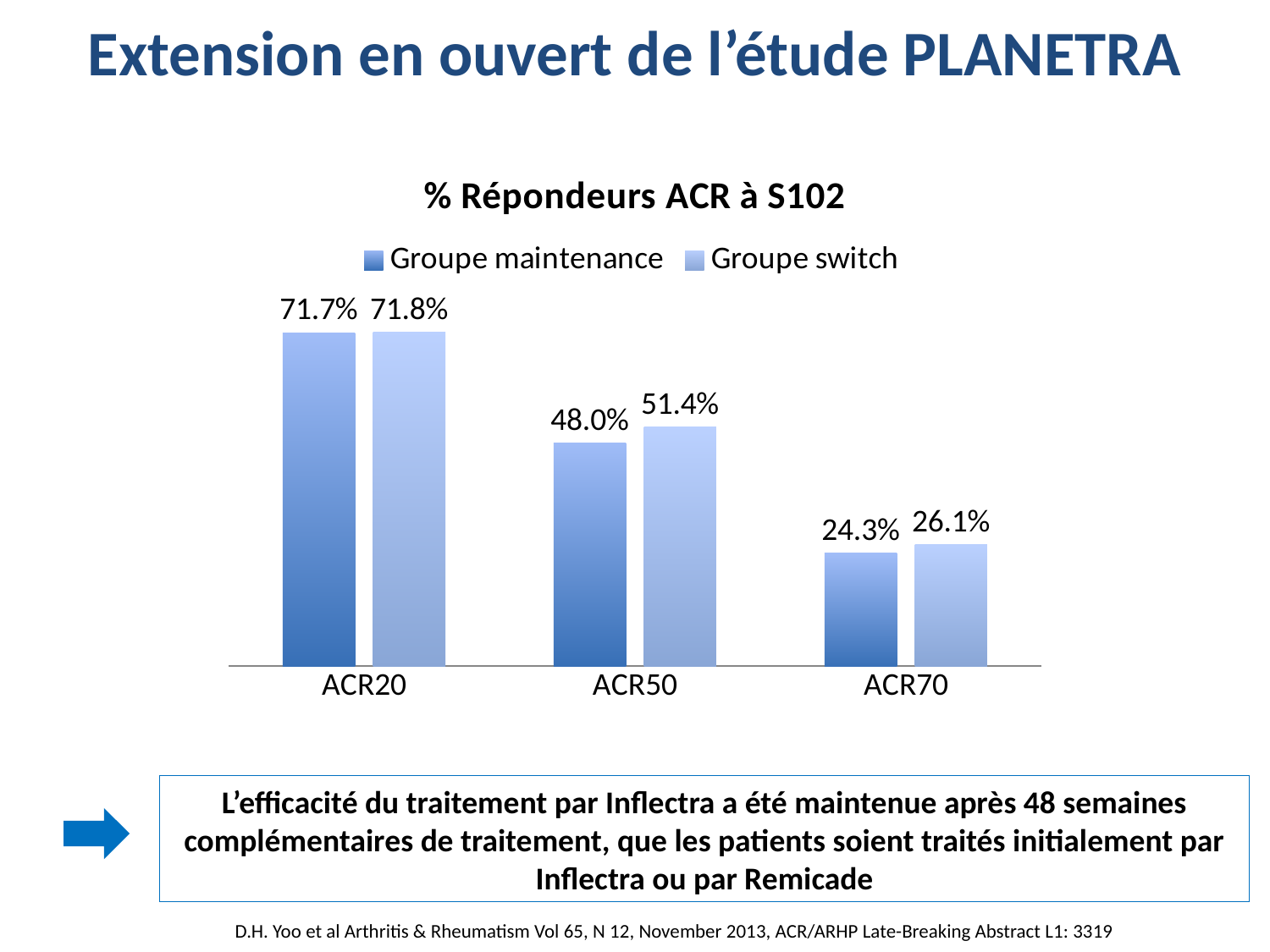
At ACR70, which group has the larger value, Groupe maintenance or Groupe switch? Groupe switch What is the value for Groupe maintenance at ACR20? 71.7% What is the value for Groupe maintenance at ACR70? 24.3% What is the title of the chart? % Répondeurs ACR à S102 How many categories are shown on the x axis? 3 What is the value for Groupe switch at ACR50? 51.4% Which category has the highest value for Groupe switch? ACR20 How many series does the legend list? 2 What is the value for Groupe switch at ACR70? 26.1% What kind of chart is shown? Bar chart Which category has the lowest value for Groupe maintenance? ACR70 What is the difference between Groupe switch and Groupe maintenance at ACR50? 3.4%